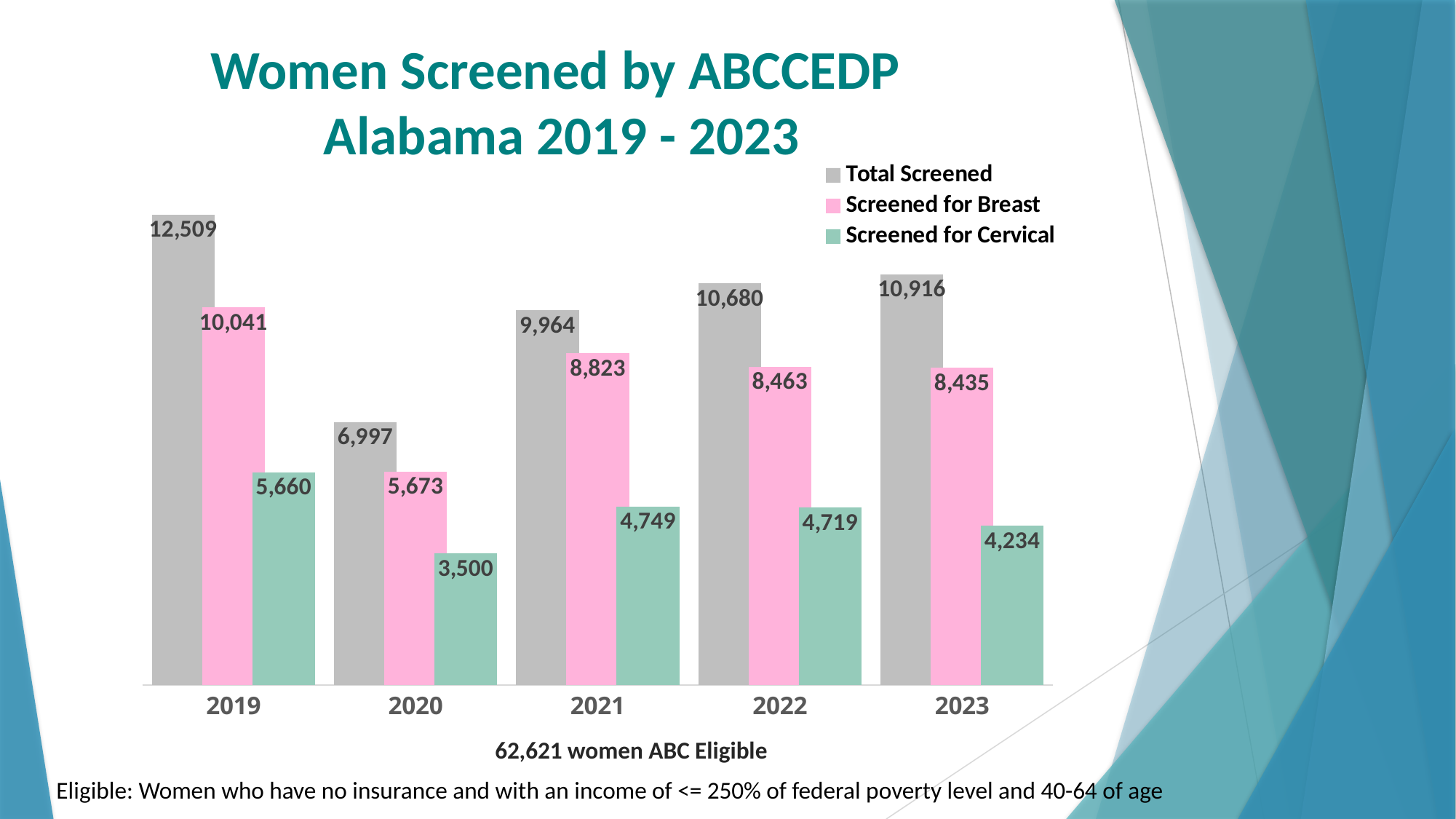
Which year had the highest Screened for Breast value? 2019 Which is larger: Screened for Cervical in 2021 or Screened for Cervical in 2023? 2021 What was the Total Screened value in 2019? 12,509 How many series does the legend list? 3 Which year had the lowest Total Screened value? 2020 How many women were Screened for Cervical in 2020? 3,500 What colour represents the Screened for Breast series? Pink What was the Screened for Breast value in 2023? 8,435 What is the difference between Total Screened in 2019 and Total Screened in 2020? 5,512 Did the Screened for Cervical values rise or fall from 2021 to 2023? Fall What kind of chart is shown on the slide? Bar chart How many years are shown on the x axis? 5